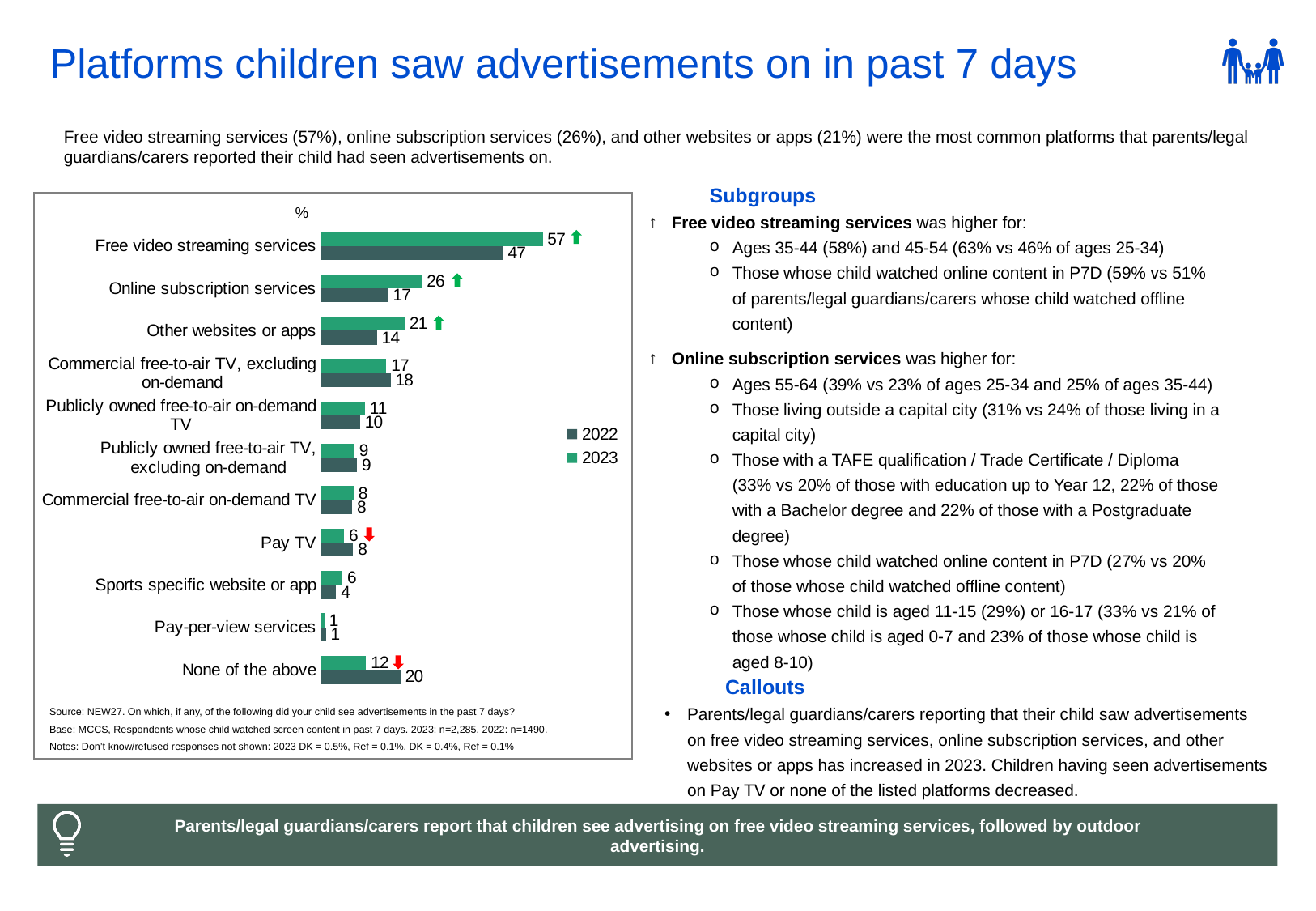
For Pay TV, which year has the larger value, 2022 or 2023? 2022 What is the difference between the 2022 and 2023 values for None of the above? 8 What is the 2022 value for None of the above? 20 How many platform categories are shown in the chart? 11 What is the 2023 value for Free video streaming services? 57 What is the difference between the 2023 and 2022 values for Free video streaming services? 10 For Other websites or apps, which year has the larger value, 2022 or 2023? 2023 Which platform has the lowest 2022 value? Pay-per-view services Which platform has the highest 2023 value? Free video streaming services How many series does the legend list? 2 What type of chart is shown on the slide? Bar chart What is the 2022 value for Online subscription services? 17